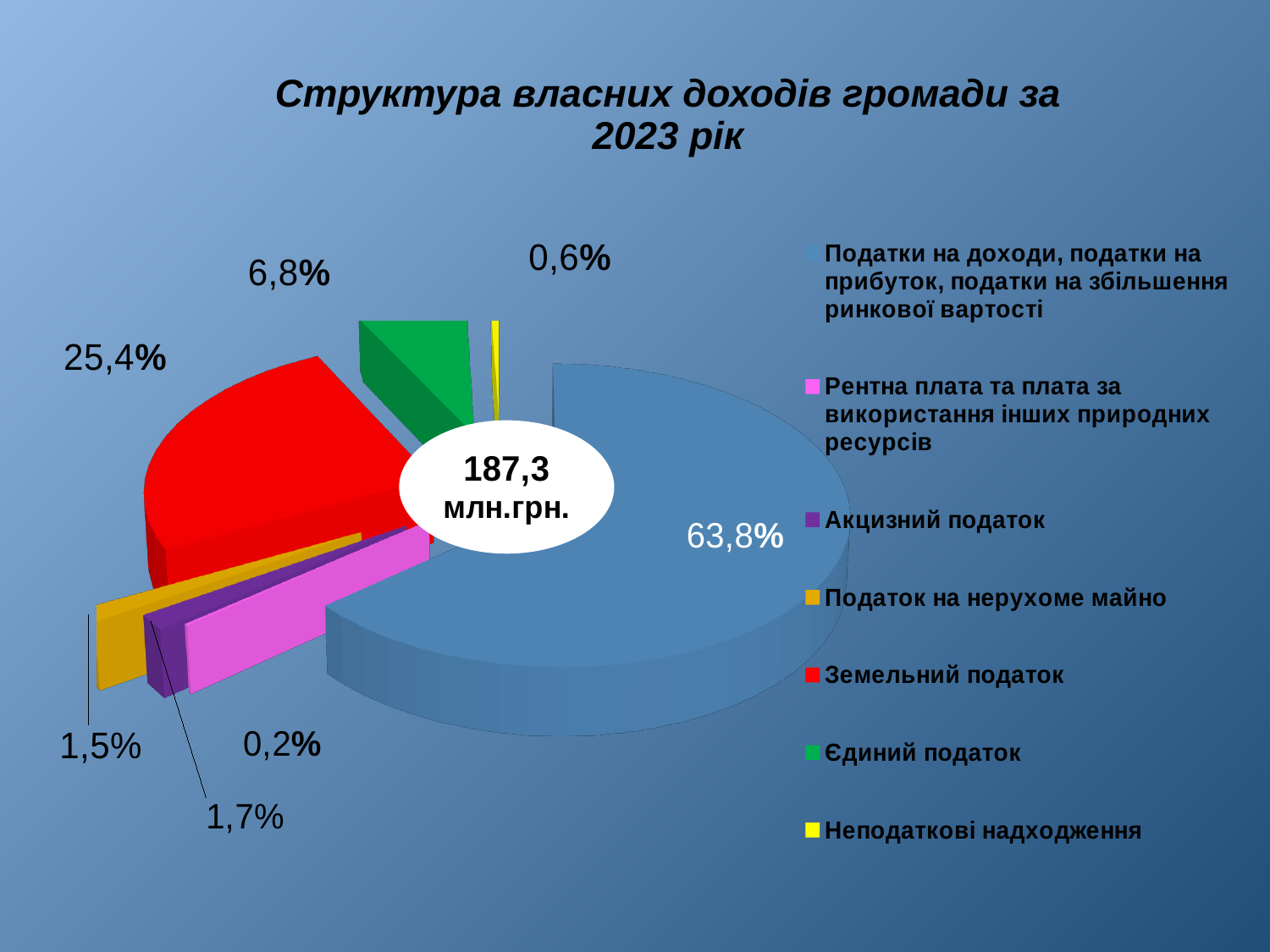
Which has a larger share: "Податок на нерухоме майно" or "Акцизний податок"? Акцизний податок What share of the pie does "Неподаткові надходження" have? 0,6% What share of the pie does "Податки на доходи, податки на прибуток, податки на збільшення ринкової вартості" have? 63,8% Which category has the largest share of the pie? Податки на доходи, податки на прибуток, податки на збільшення ринкової вартості What share of the pie does "Єдиний податок" have? 6,8% What is the difference in percentage points between the shares of "Земельний податок" and "Єдиний податок"? 18,6 What total amount is printed in the centre of the pie chart? 187,3 млн.грн. What kind of chart is shown on the slide? pie chart What share of the pie does "Земельний податок" have? 25,4% Which category has the smallest share of the pie? Рентна плата та плата за використання інших природних ресурсів What share of the pie does "Акцизний податок" have? 1,7% How many categories does the legend list? 7